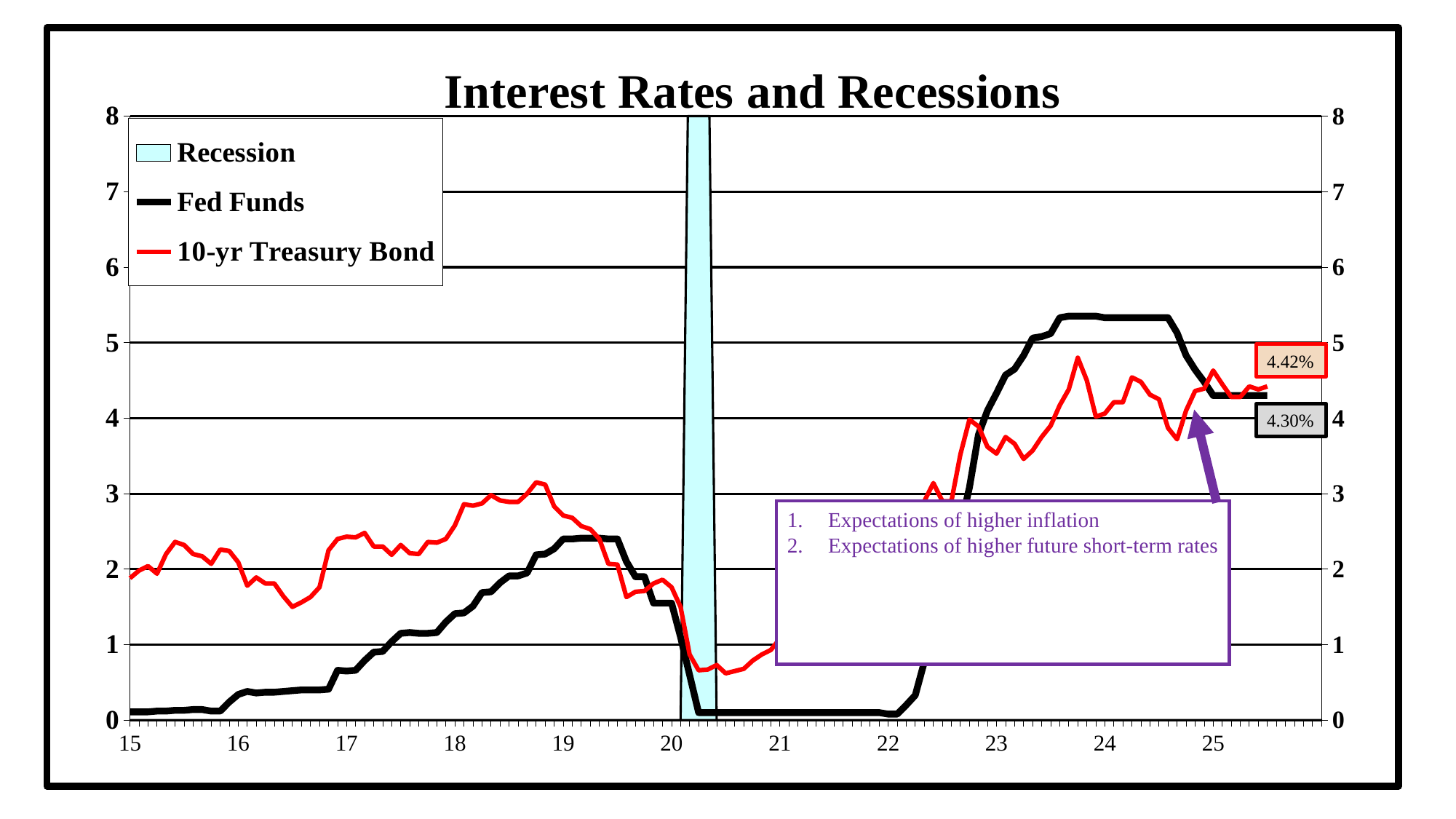
What is the difference between the labelled 10-yr Treasury Bond value (4.42%) and the labelled Fed Funds value (4.30%)? 0.12% Is the Fed Funds value during 2021 greater or less than 1? less What is the latest labelled value for the 10-yr Treasury Bond? 4.42% Which series reaches a higher peak around 2023-2024, Fed Funds or the 10-yr Treasury Bond? Fed Funds What is the latest labelled value for Fed Funds? 4.30% Is the peak Fed Funds value around 2024 greater or less than 5? greater At the end of the chart, which is higher: the 10-yr Treasury Bond or Fed Funds? 10-yr Treasury Bond How many entries does the chart's legend list? 3 Is the 10-yr Treasury Bond value during 2016 greater or less than 3? less Does the Fed Funds rate rise or fall between 2022 and 2023? rise What kind of chart is shown on the slide? line chart What is the title of the chart? Interest Rates and Recessions